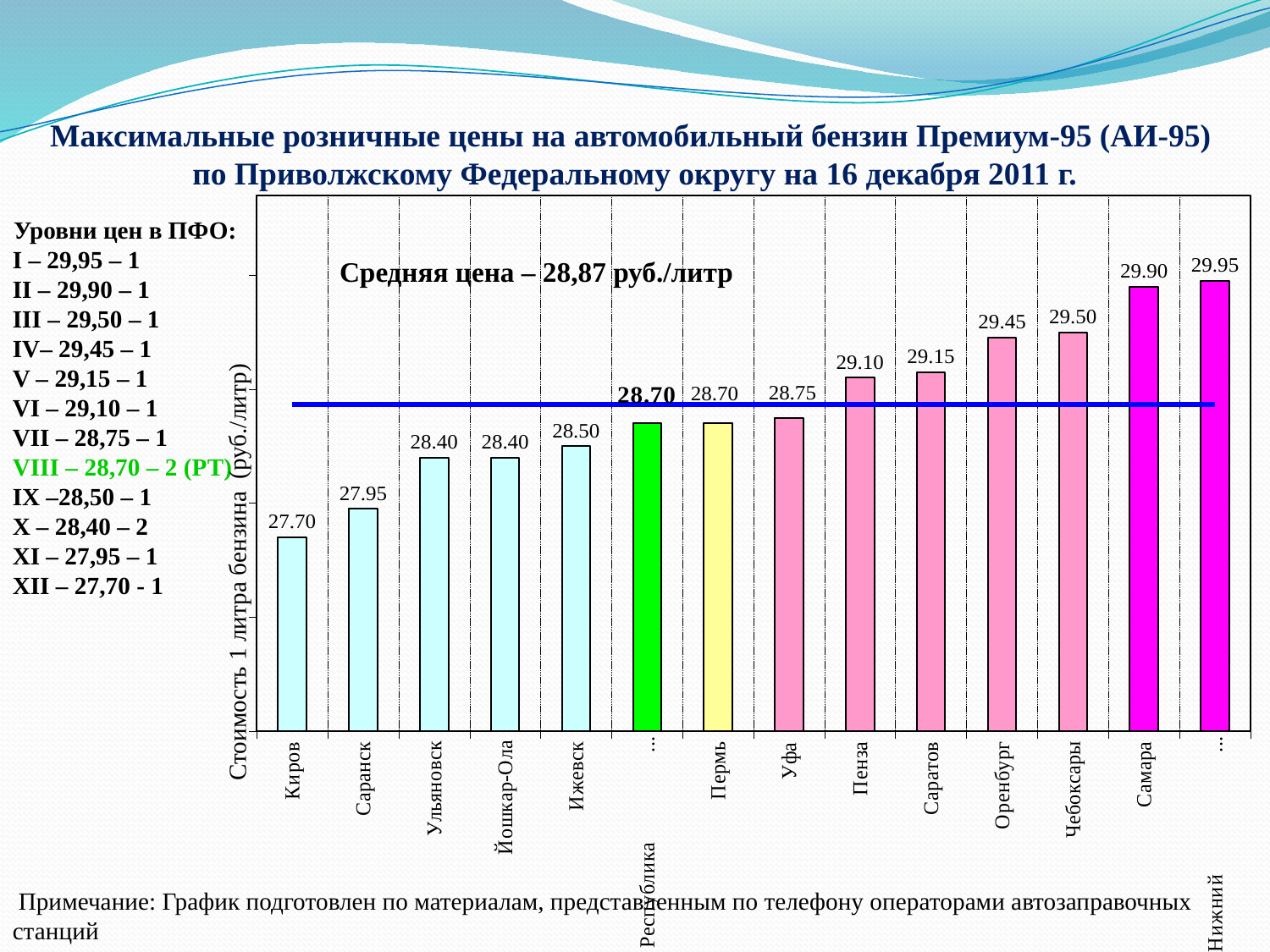
What is the value for Чебоксары? 29.50 What is the value for Уфа? 28.75 What is the value for Саратов? 29.15 What is the value for Киров? 27.70 What average price is stated on the chart? 28,87 руб./литр Which labelled city has the lowest value? Киров What is the difference between the values for Самара and Киров? 2.20 How many bars are plotted in the chart? 14 What is the difference between the values for Пенза and Саранск? 1.15 Do the values rise or fall from left to right along the x axis? rise Which city has the higher value, Самара or Оренбург? Самара What kind of chart is shown on the slide? bar chart